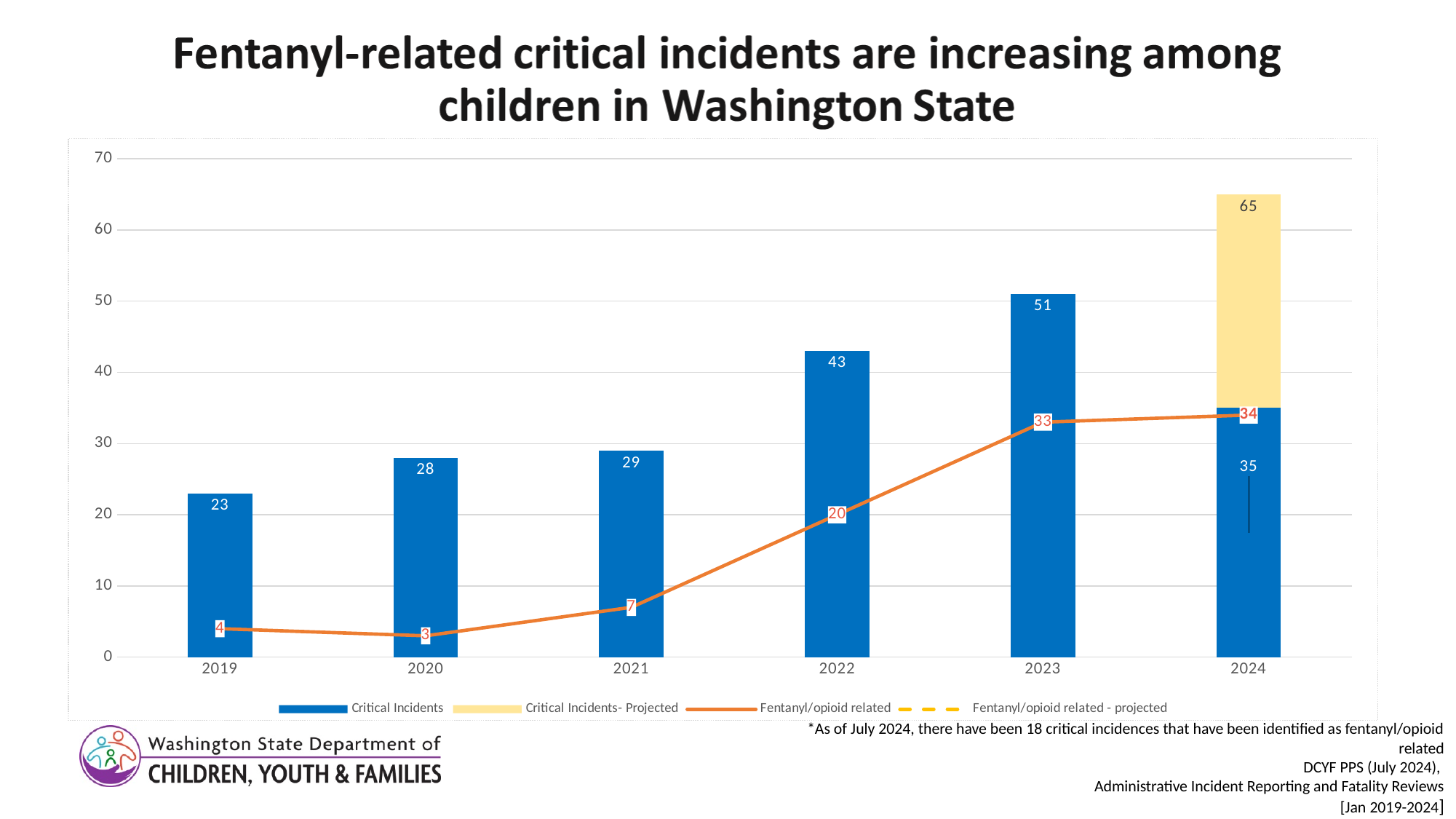
Which year has the larger Critical Incidents value, 2020 or 2021? 2021 Does the Fentanyl/opioid related line rise or fall from 2021 to 2023? Rise How many years are shown on the x axis? 6 What value is labelled on the Critical Incidents- Projected bar for 2024? 65 What is the value of Critical Incidents for 2019? 23 What is the Critical Incidents value for 2024? 35 What is the difference between the Critical Incidents values for 2023 and 2022? 8 What kind of chart is this? Bar chart with a line series Which year has the lowest Fentanyl/opioid related value? 2020 Which year has the highest Critical Incidents value among the blue bars? 2023 How many series does the legend list? 4 What is the Fentanyl/opioid related value for 2022? 20